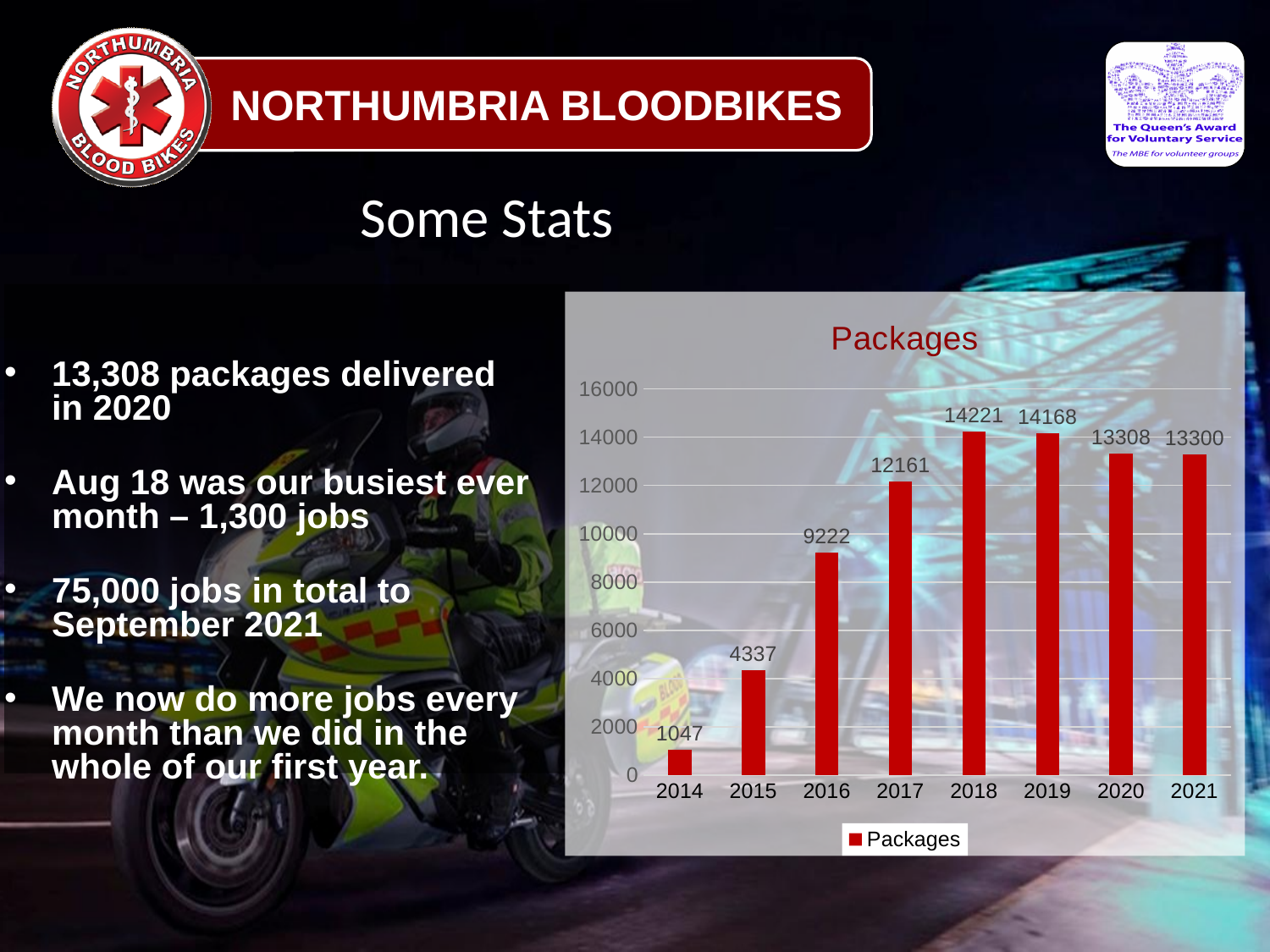
What is the value for 2021 in the Packages chart? 13300 Which year has the lowest value in the Packages chart? 2014 What is the value for 2017 in the Packages chart? 12161 Which is larger in the Packages chart, the value for 2019 or the value for 2020? 2019 Which year has the highest value in the Packages chart? 2018 How many years are shown on the x axis of the Packages chart? 8 How many series does the legend of the Packages chart list? 1 Is the value for 2016 in the Packages chart greater or less than 10000? less What is the value for 2014 in the Packages chart? 1047 What kind of chart is the Packages chart? bar chart What is the title of the chart on the slide? Packages What is the difference between the values for 2016 and 2015 in the Packages chart? 4885